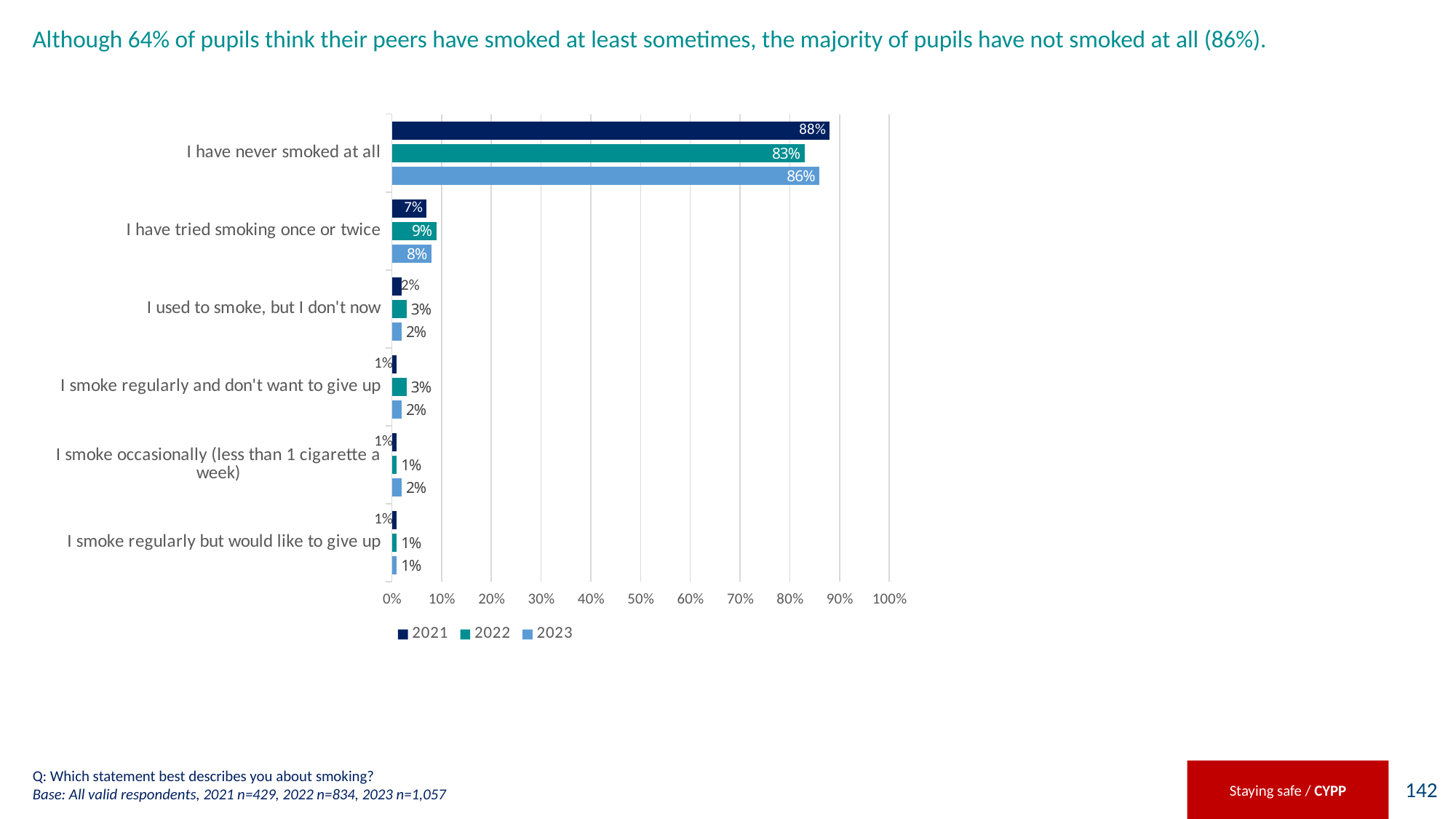
What type of chart is shown on the slide? Bar chart What percentage of pupils said they have never smoked at all in 2023? 86% Which year had the highest value for 'I have never smoked at all'? 2021 Which statement had the highest percentage in 2023? I have never smoked at all Is the 2022 value for 'I have never smoked at all' greater or less than 80%? greater Which years are listed in the chart legend? 2021, 2022, 2023 Which is larger: the 2022 value or the 2023 value for 'I have tried smoking once or twice'? 2022 What was the value for 'I used to smoke, but I don't now' in 2021? 2% How many statements (categories) are shown on the chart? 6 What is the difference between the 2021 and 2022 values for 'I have never smoked at all'? 5 percentage points What percentage of pupils said they have tried smoking once or twice in 2022? 9% How many series does the legend list? 3